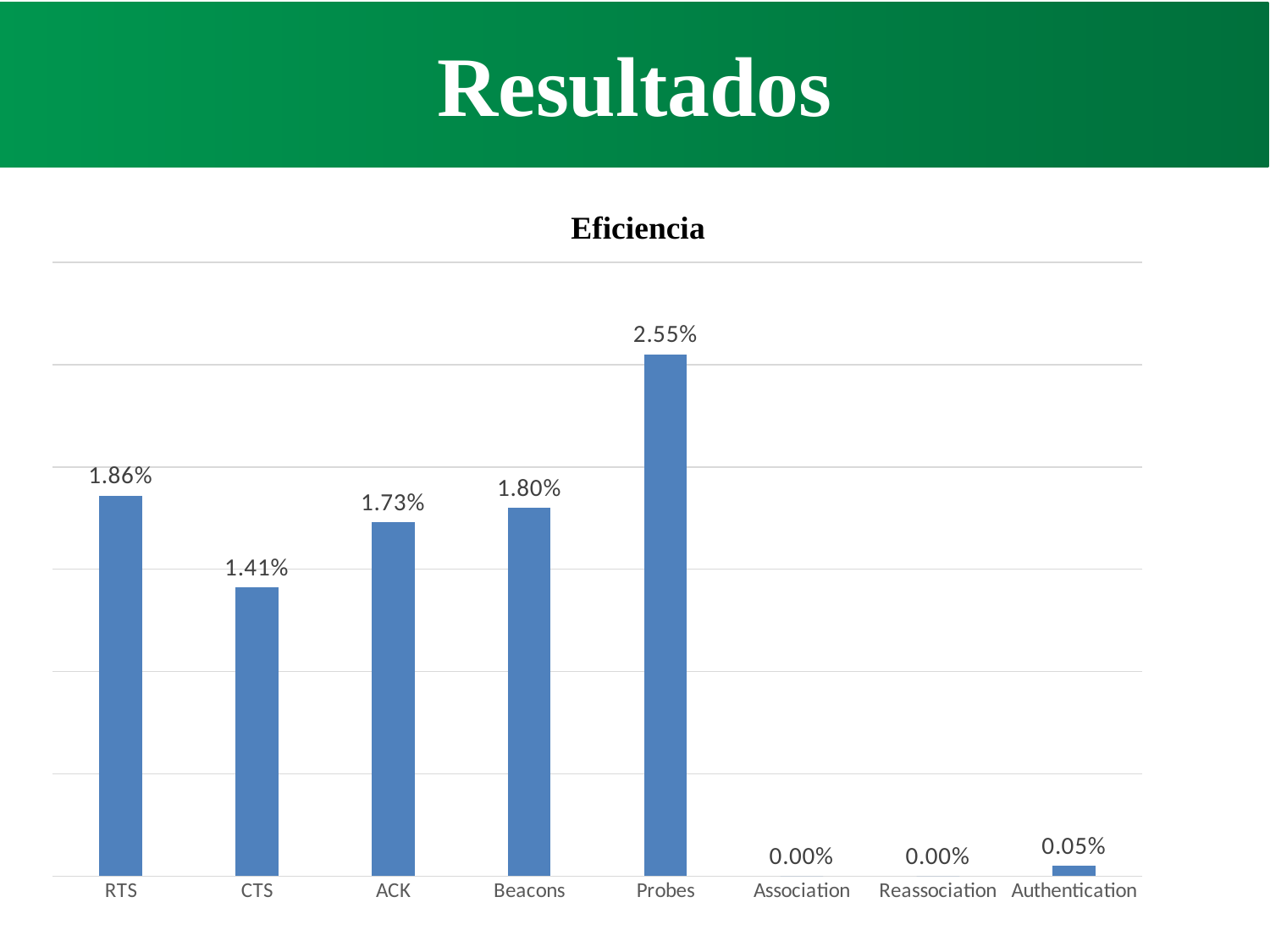
What is the value for Probes in the Eficiencia chart? 2.55% What is the value for Authentication in the Eficiencia chart? 0.05% What is the value for CTS in the Eficiencia chart? 1.41% How many categories are shown on the x axis of the Eficiencia chart? 8 What kind of chart is shown on the slide? Bar chart What is the title of the chart on the slide? Eficiencia How many categories in the Eficiencia chart have a value of 0.00%? 2 What is the value for Beacons in the Eficiencia chart? 1.80% What is the difference between the values for RTS and CTS in the Eficiencia chart? 0.45% Which is larger in the Eficiencia chart, the value for ACK or the value for Beacons? Beacons What is the difference between the values for Probes and RTS in the Eficiencia chart? 0.69% Which category has the highest value in the Eficiencia chart? Probes